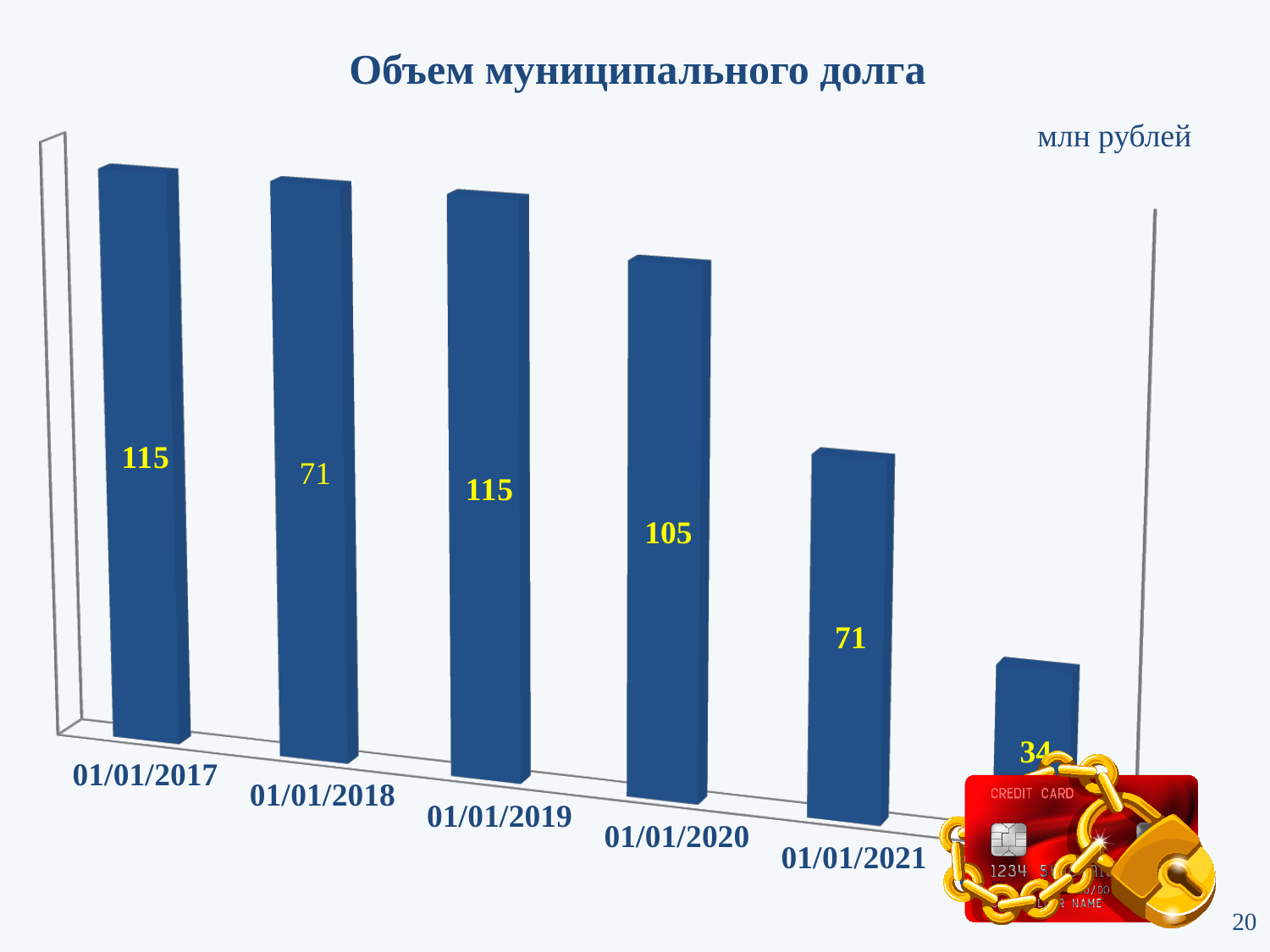
What is the value for 01/01/2018? 71 In what units are the values on the chart given? млн рублей What is the value for 01/01/2021? 71 What is the title of the chart? Объем муниципального долга What is the value for 01/01/2019? 115 What kind of chart is shown on the slide? Bar chart What is the difference between the values for 01/01/2020 and 01/01/2021? 34 What is the difference between the values for 01/01/2019 and 01/01/2020? 10 How many bars are plotted in the chart? 6 What is the value for 01/01/2020? 105 Which is larger, the value for 01/01/2020 or the value for 01/01/2021? 01/01/2020 What is the value for 01/01/2017? 115